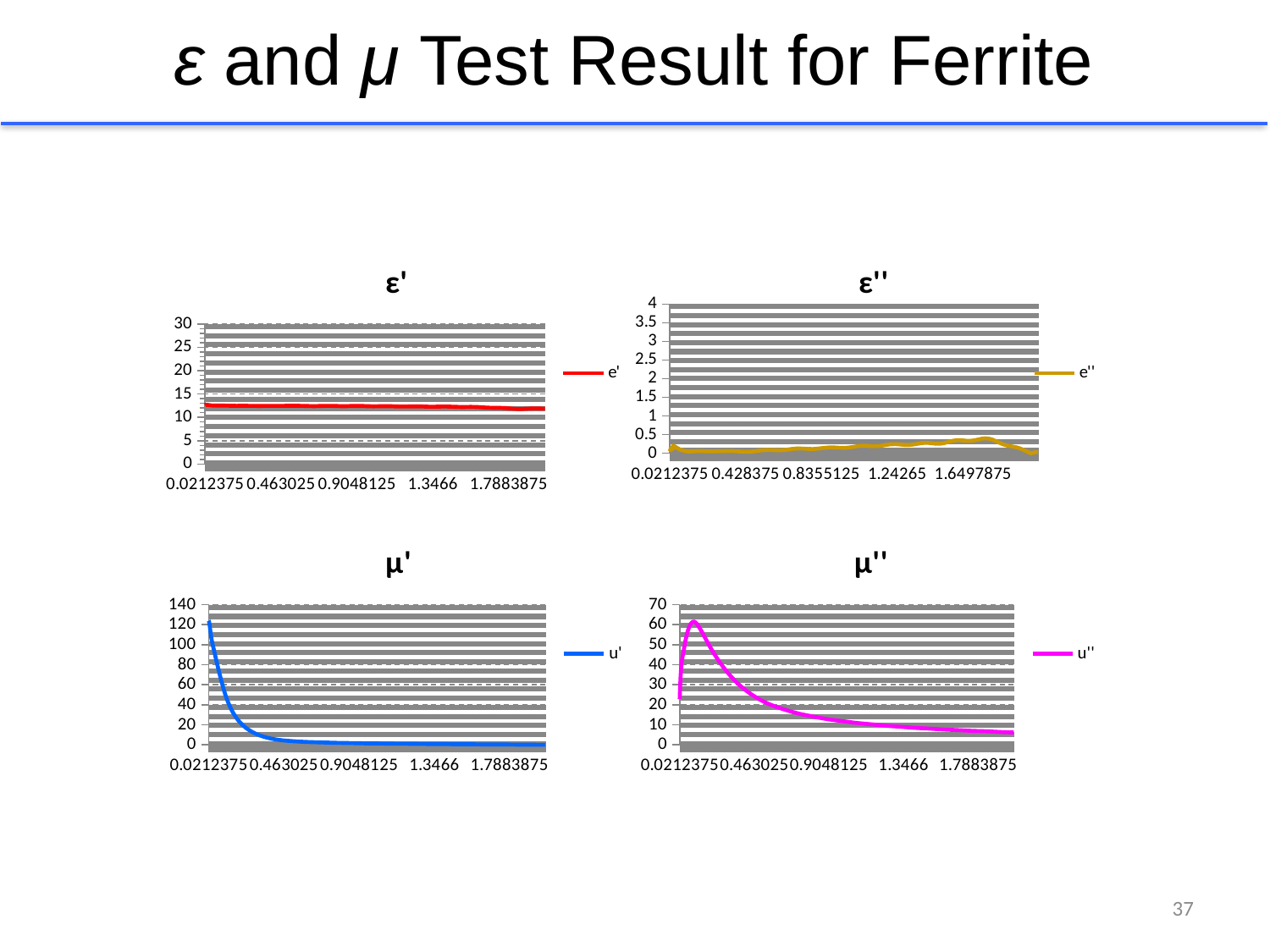
What colour is the line in the μ' chart? blue In the μ' chart, is the value at the first x-axis point (0.0212375) greater or less than 100? greater In the μ'' chart, is the value at 1.7883875 greater or less than 20? less In the μ' chart, do the values rise or fall along the x axis? fall In the μ' chart, is the value at 1.7883875 greater or less than 20? less What is the legend entry shown on the ε'' chart? e'' How many series does the legend of the μ'' chart list? 1 What kind of chart is the ε' chart? line chart